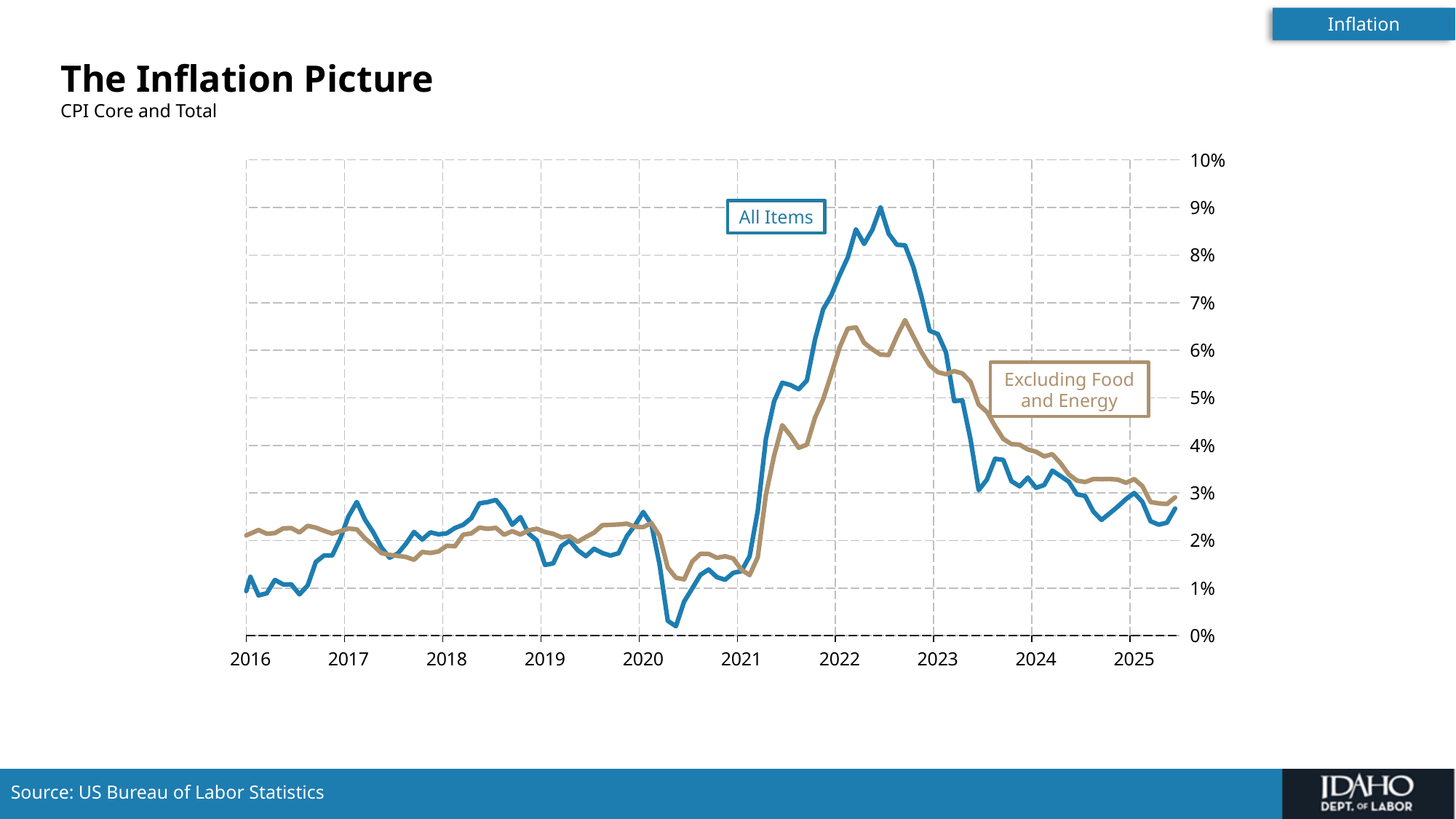
Is the peak value of the Excluding Food and Energy series greater or less than 7%? less Is the lowest value of the All Items series in 2020 greater or less than 1%? less Which series reaches the higher peak in 2022, All Items or Excluding Food and Energy? All Items How many year labels are shown on the x axis? 10 Which series is higher at the start of 2016, All Items or Excluding Food and Energy? Excluding Food and Energy What is the title of the slide's chart? The Inflation Picture What source is cited for the chart data? US Bureau of Labor Statistics Does the All Items series rise or fall between its 2022 peak and 2024? fall Is the peak value of the All Items series in 2022 greater or less than 8%? greater What kind of chart is shown on the slide? line chart How many data series are plotted on the chart? 2